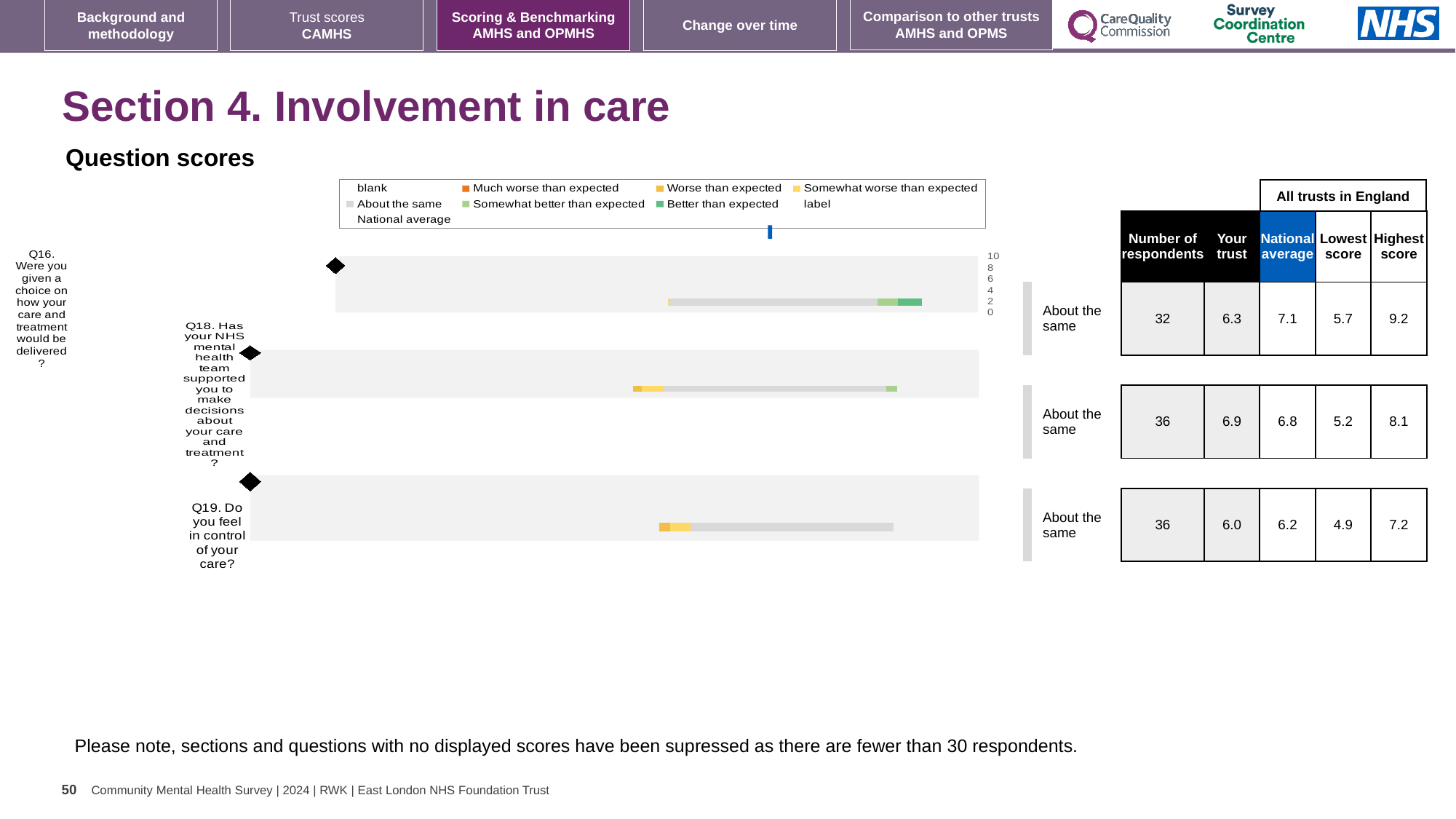
What is the maximum value shown on the chart's score axis? 10 Which question has the lowest 'Your trust' score in the table beside the chart? Q19 What is the difference between the 'Your trust' score and the national average for Q18? 0.1 Which question has the highest 'Your trust' score in the table beside the chart? Q18 How many questions (categories) are plotted in the question scores chart? 3 How many respondents are listed for Q16 in the table beside the chart? 32 What kind of chart is used to show the question scores on this slide? bar chart According to the table beside the chart, what is the national average for Q16? 7.1 What is the highest score among all trusts in England for Q19? 7.2 In the chart legend, what colour represents 'Better than expected'? green According to the table beside the chart, what is the 'Your trust' score for Q19 (Do you feel in control of your care?)? 6.0 For Q16, which is larger: the 'Your trust' score or the national average? National average